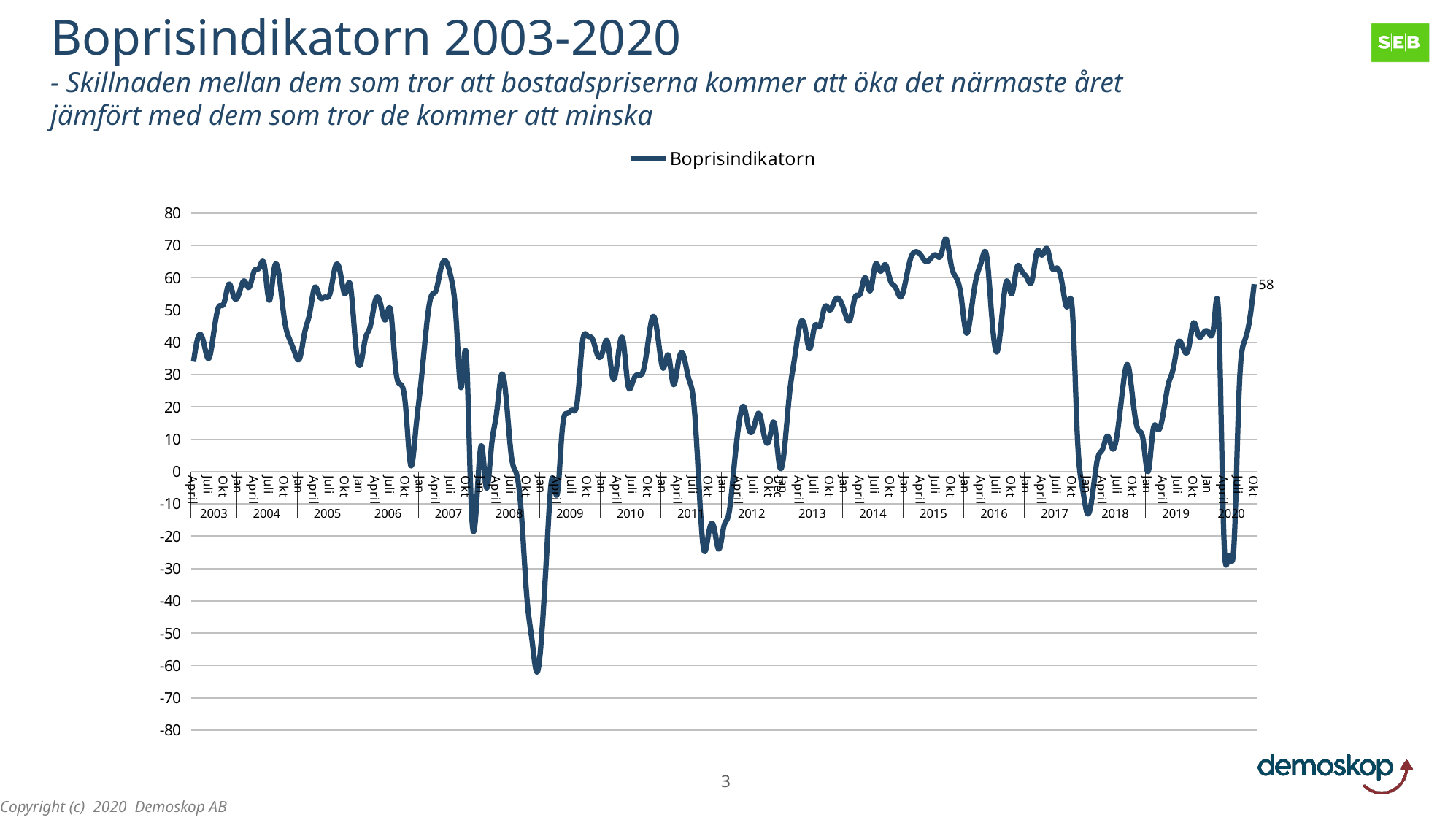
What is the highest value shown on the vertical axis? 80 Is the lowest point of the line (around the turn of 2008/2009) greater or less than -50? less Is the value for Okt 2020 greater or less than 50? greater How many series does the legend list? 1 What is the title of the chart on the slide? Boprisindikatorn 2003-2020 Does the line rise or fall between April 2020 and Okt 2020? rise Is the lowest value reached in 2020 greater or less than -20? less What kind of chart is shown on the slide? line chart In which year does the line reach its highest value? 2015 How many years are labelled along the x axis? 18 What is the value of the data label at the end of the line (Okt 2020)? 58 What is the name of the series shown in the legend? Boprisindikatorn